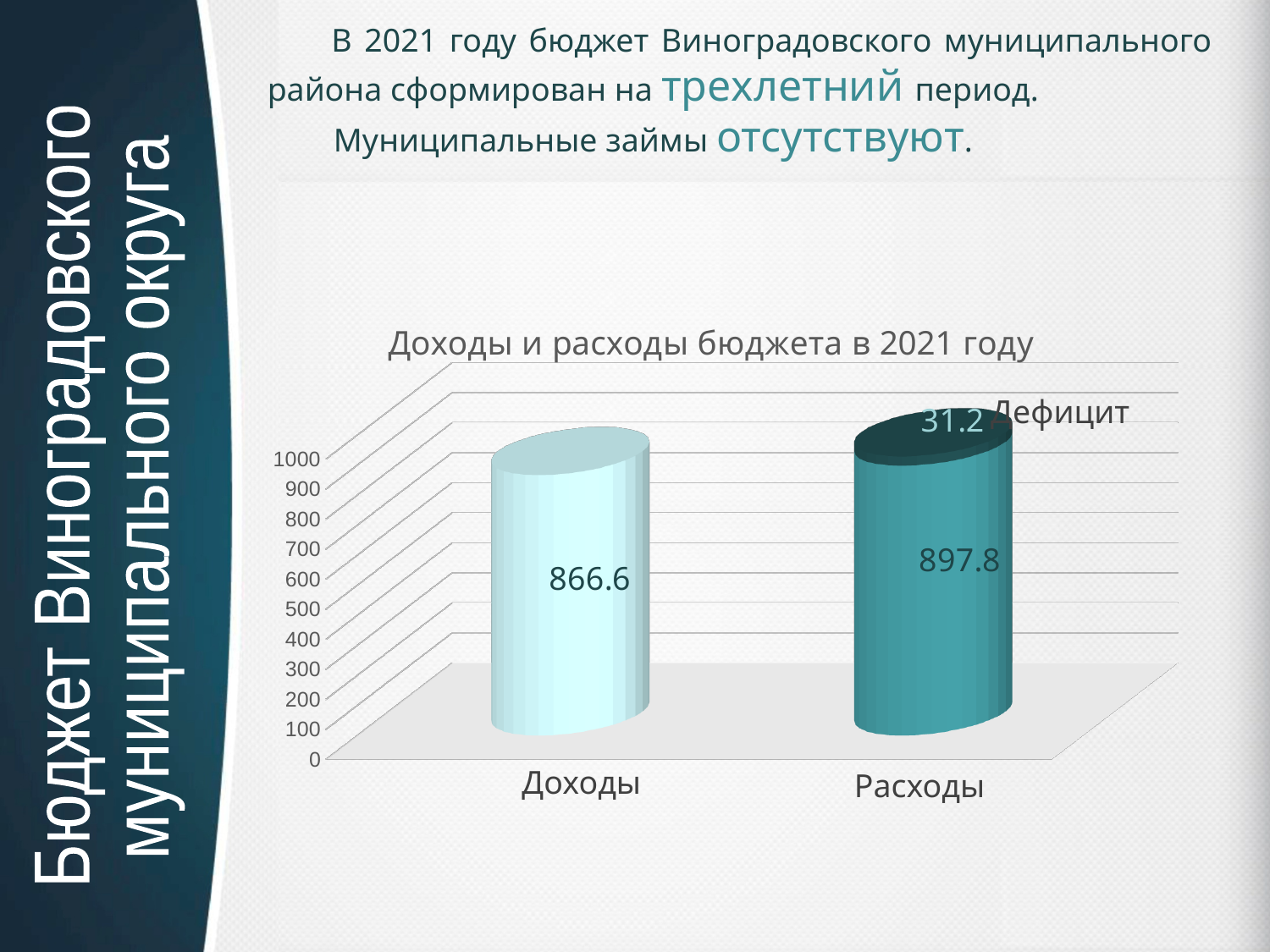
How many categories are shown on the chart? 2 What kind of chart is shown on the slide? bar chart What is the title of the chart? Доходы и расходы бюджета в 2021 году What value is labelled as Дефицит on the chart? 31.2 Which category has the higher value, Доходы or Расходы? Расходы What is the value for Расходы? 897.8 Which category has the highest value? Расходы What is the difference between the values for Расходы and Доходы? 31.2 Is the value for Расходы greater or less than 800? greater What is the value for Доходы? 866.6 Is the value for Доходы greater or less than 900? less Which category has the lowest value? Доходы